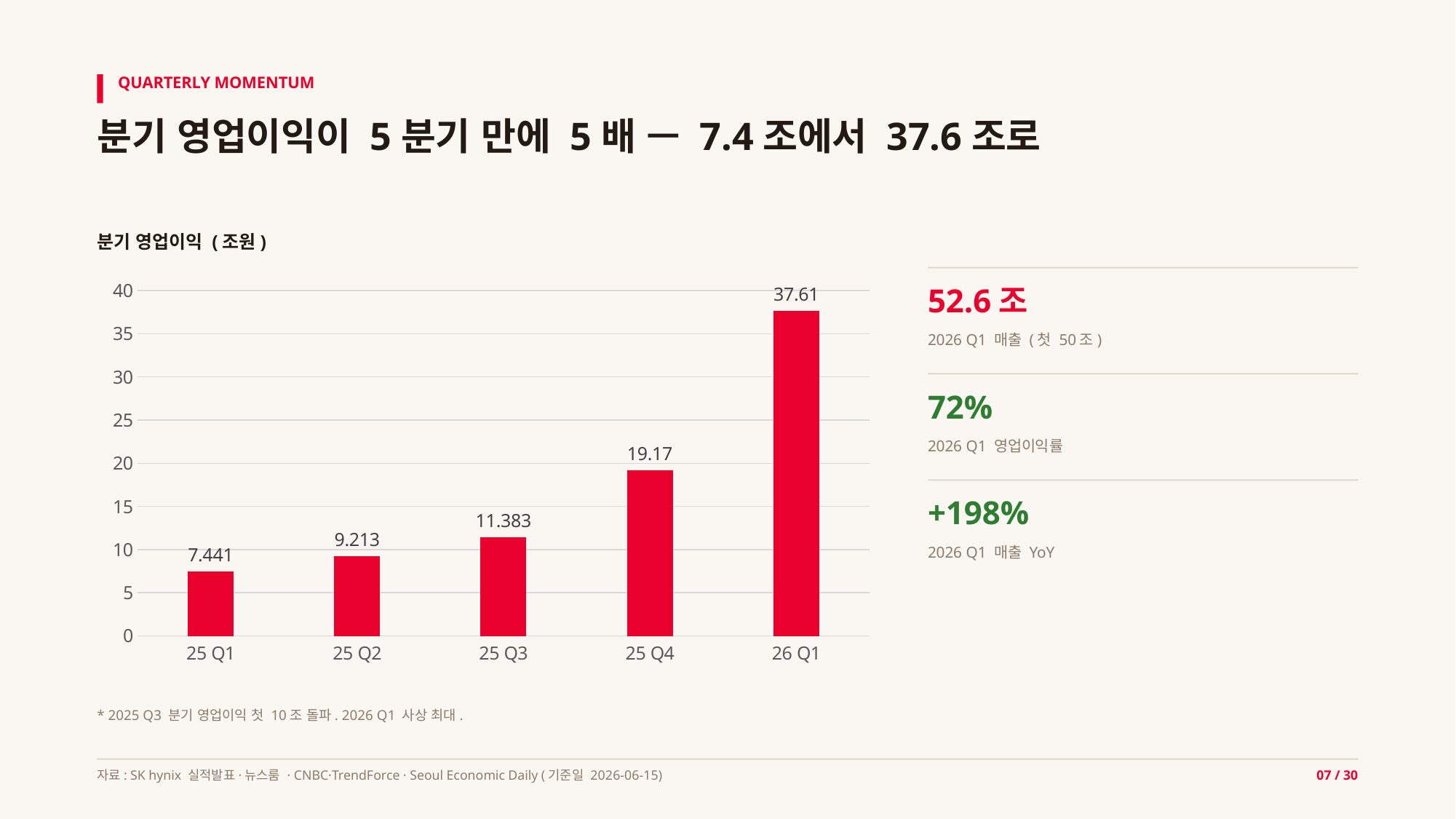
Do the operating profit values rise or fall from 25 Q1 to 26 Q1? rise What is the difference in operating profit between 25 Q2 and 25 Q1? 1.772 Which quarter has the highest operating profit? 26 Q1 What is the quarterly operating profit for 26 Q1? 37.61 What is the difference in operating profit between 26 Q1 and 25 Q4? 18.44 Which is larger, the operating profit for 25 Q4 or for 25 Q3? 25 Q4 What kind of chart is shown on the slide? bar chart What is the quarterly operating profit for 25 Q1? 7.441 Is the value for 25 Q4 greater or less than 20? less How many quarters are shown in the chart? 5 What is the quarterly operating profit for 25 Q3? 11.383 Which quarter has the lowest operating profit? 25 Q1